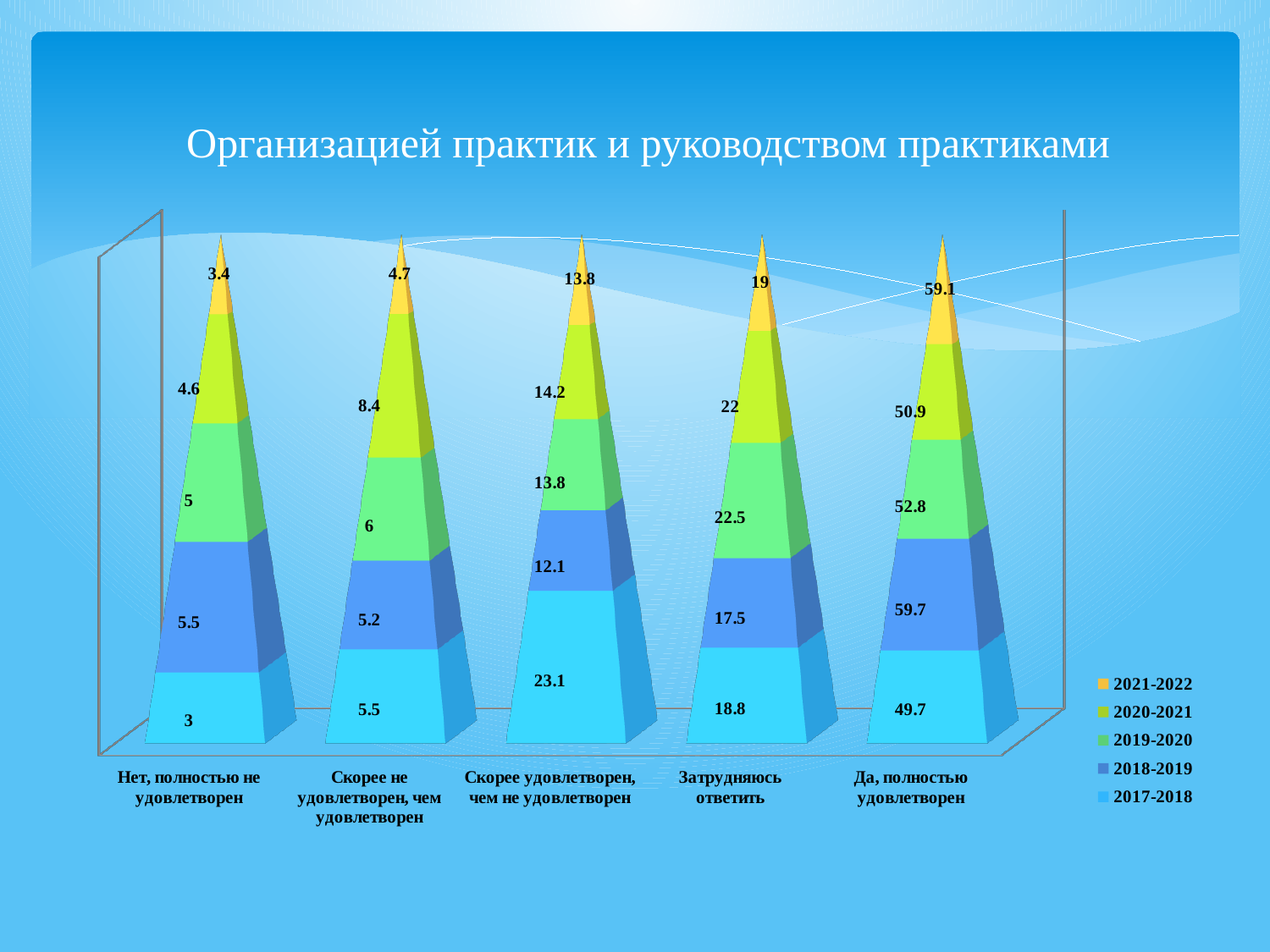
What is the value for 2020-2021 in the category "Скорее не удовлетворен, чем удовлетворен"? 8.4 What is the value for 2021-2022 in the category "Затрудняюсь ответить"? 19 How many categories are shown on the x axis? 5 Which category has the lowest value for the 2017-2018 series? Нет, полностью не удовлетворен What is the value for 2017-2018 in the category "Да, полностью удовлетворен"? 49.7 What is the difference between the 2018-2019 and 2017-2018 values in the category "Да, полностью удовлетворен"? 10 Which is larger in the category "Затрудняюсь ответить": the 2019-2020 value or the 2018-2019 value? 2019-2020 What is the value for 2019-2020 in the category "Скорее удовлетворен, чем не удовлетворен"? 13.8 What kind of chart is shown on the slide? Stacked bar chart How many series does the legend list? 5 What is the total of all series for the category "Нет, полностью не удовлетворен"? 21.5 Which category has the highest value for the 2018-2019 series? Да, полностью удовлетворен